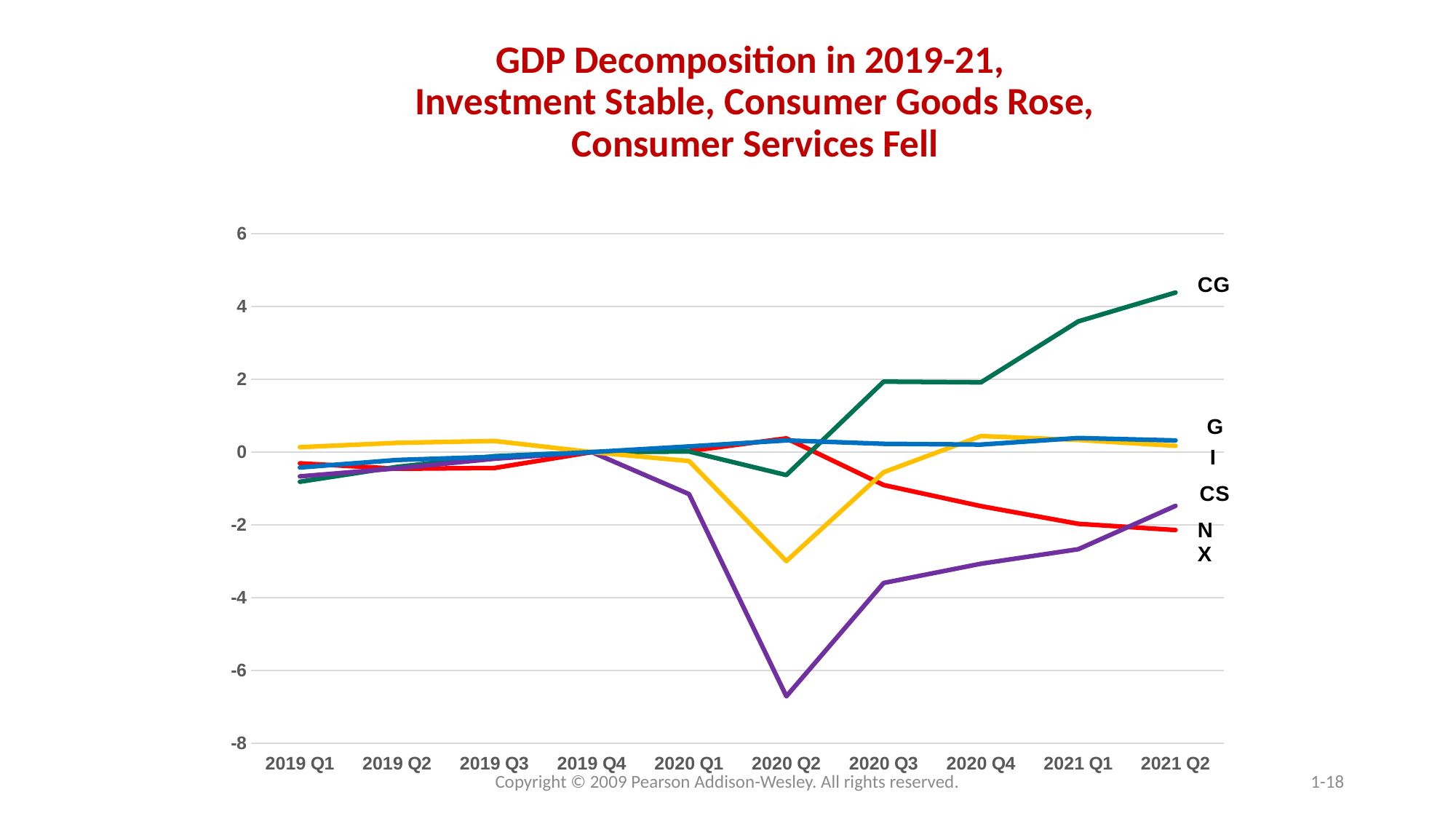
Is the value for CS in 2020 Q2 greater or less than -6? less How many quarters are shown along the x axis? 10 Is the value for I in 2020 Q2 greater or less than -2? less In 2021 Q2, which is larger, the value for CS or the value for NX? CS Which series has the lowest value in 2020 Q2? CS Does the NX series rise or fall from 2020 Q2 to 2021 Q2? fall Does the CG series rise or fall from 2020 Q2 to 2021 Q2? rise How many series are labelled on the chart? 5 What kind of chart is shown on the slide? line chart In which quarter does the CS series reach its lowest point? 2020 Q2 Which series has the highest value in 2021 Q2? CG Is the value for CG in 2021 Q2 greater or less than 4? greater